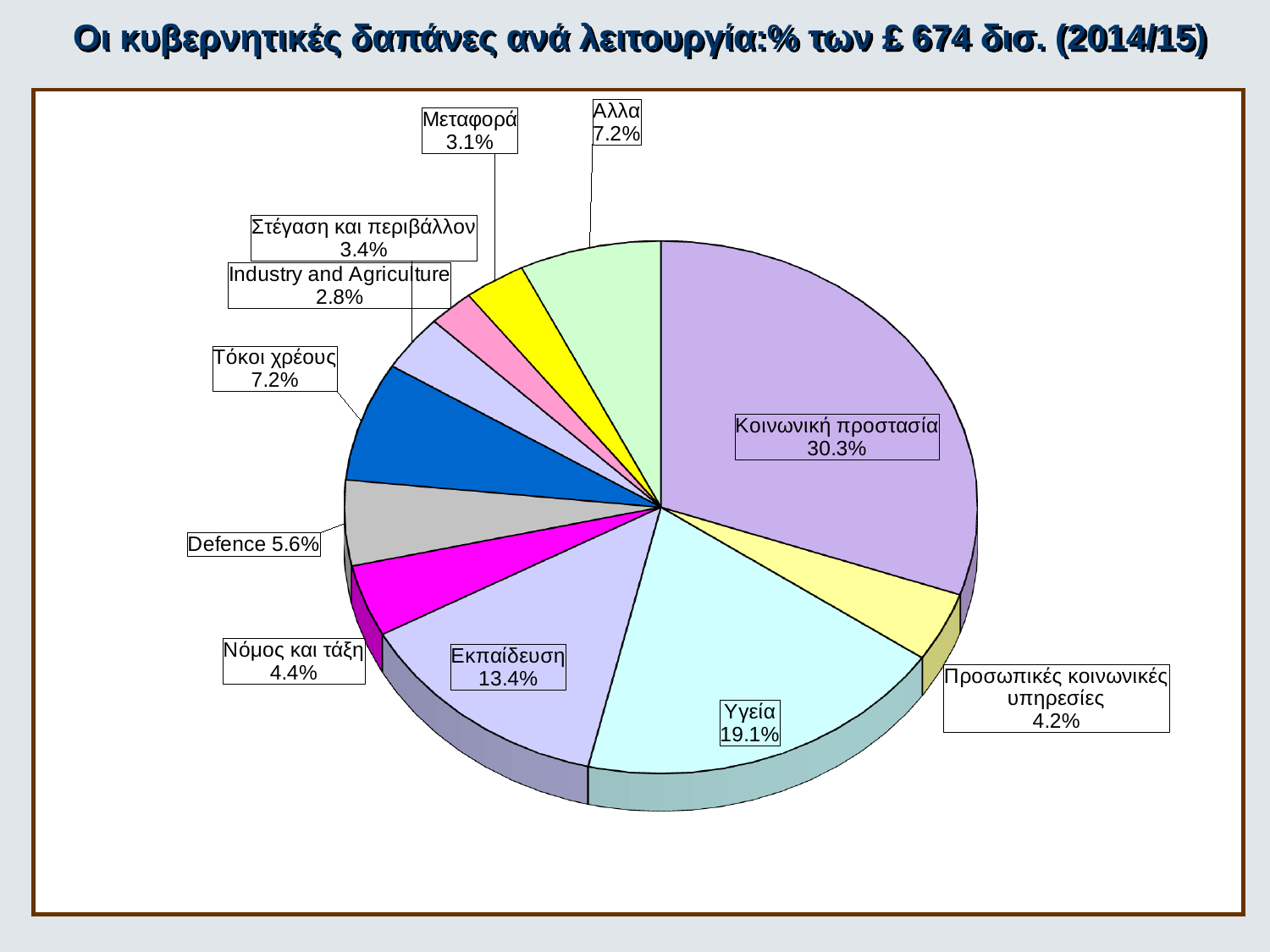
What percentage is shown for Εκπαίδευση? 13.4% Which category has the smallest share of the pie? Industry and Agriculture What type of chart is shown on the slide? pie chart What is the difference in percentage points between Υγεία and Εκπαίδευση? 5.7 How many slices does the pie chart have? 11 What percentage is shown for Υγεία? 19.1% What percentage is shown for Industry and Agriculture? 2.8% What percentage is shown for Defence? 5.6% What total amount of spending does the chart title say the percentages refer to? £ 674 δισ. What share of government spending goes to Κοινωνική προστασία? 30.3% Which category has the largest share of the pie? Κοινωνική προστασία Which is larger, the share for Νόμος και τάξη or the share for Defence? Defence